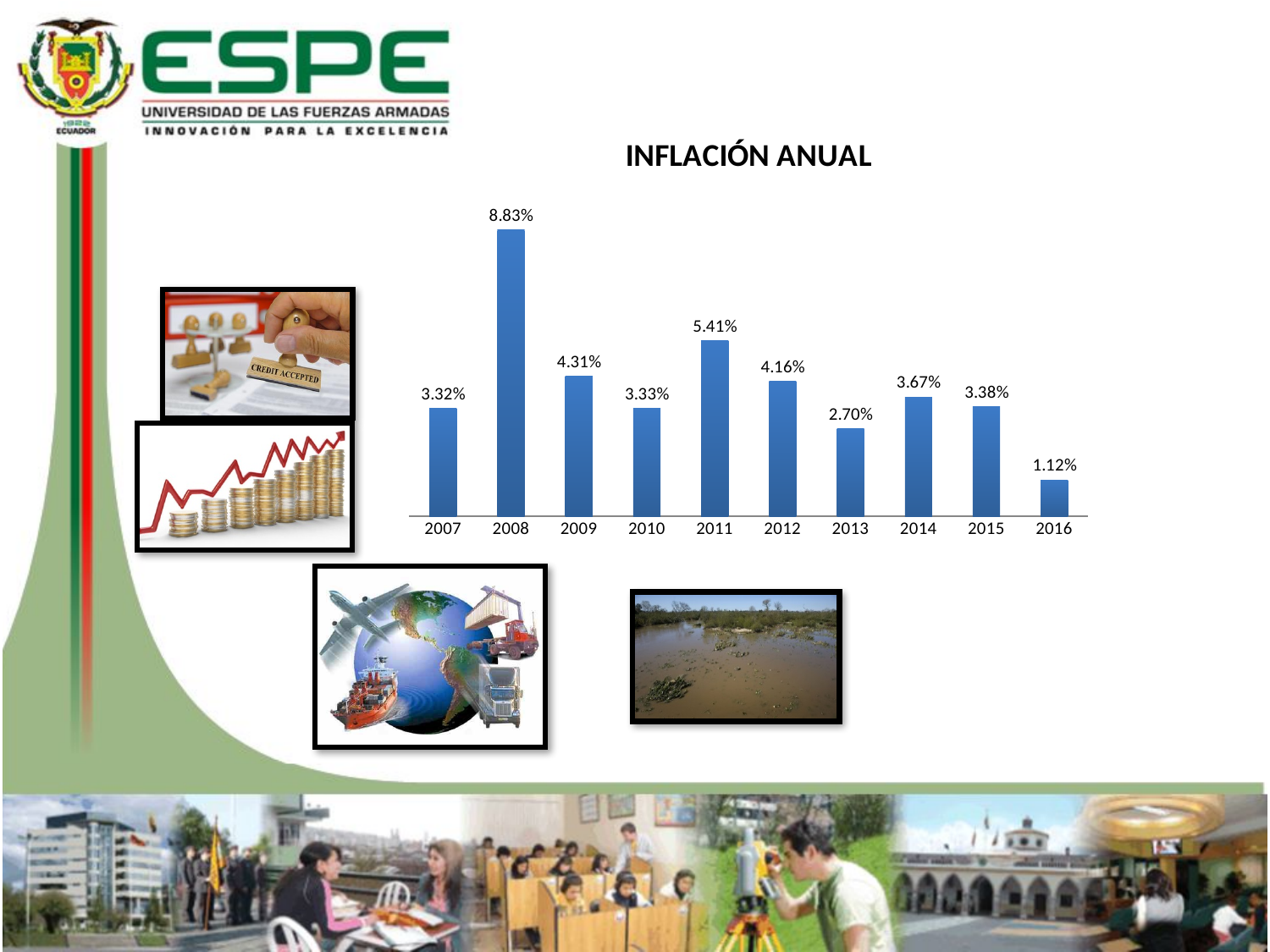
How many years are shown on the x axis of the chart? 10 What is the difference between the inflation values for 2008 and 2016? 7.71% What is the title of the chart? INFLACIÓN ANUAL What is the annual inflation value shown for 2013? 2.70% What kind of chart is used to show the annual inflation? Bar chart Which year has the lowest annual inflation in the chart? 2016 Do the inflation values rise or fall from 2014 to 2016? Fall What is the difference between the inflation values for 2011 and 2012? 1.25% Which year has the highest annual inflation in the chart? 2008 What is the annual inflation value shown for 2008? 8.83% Which year has a higher inflation value, 2009 or 2014? 2009 What is the annual inflation value shown for 2016? 1.12%